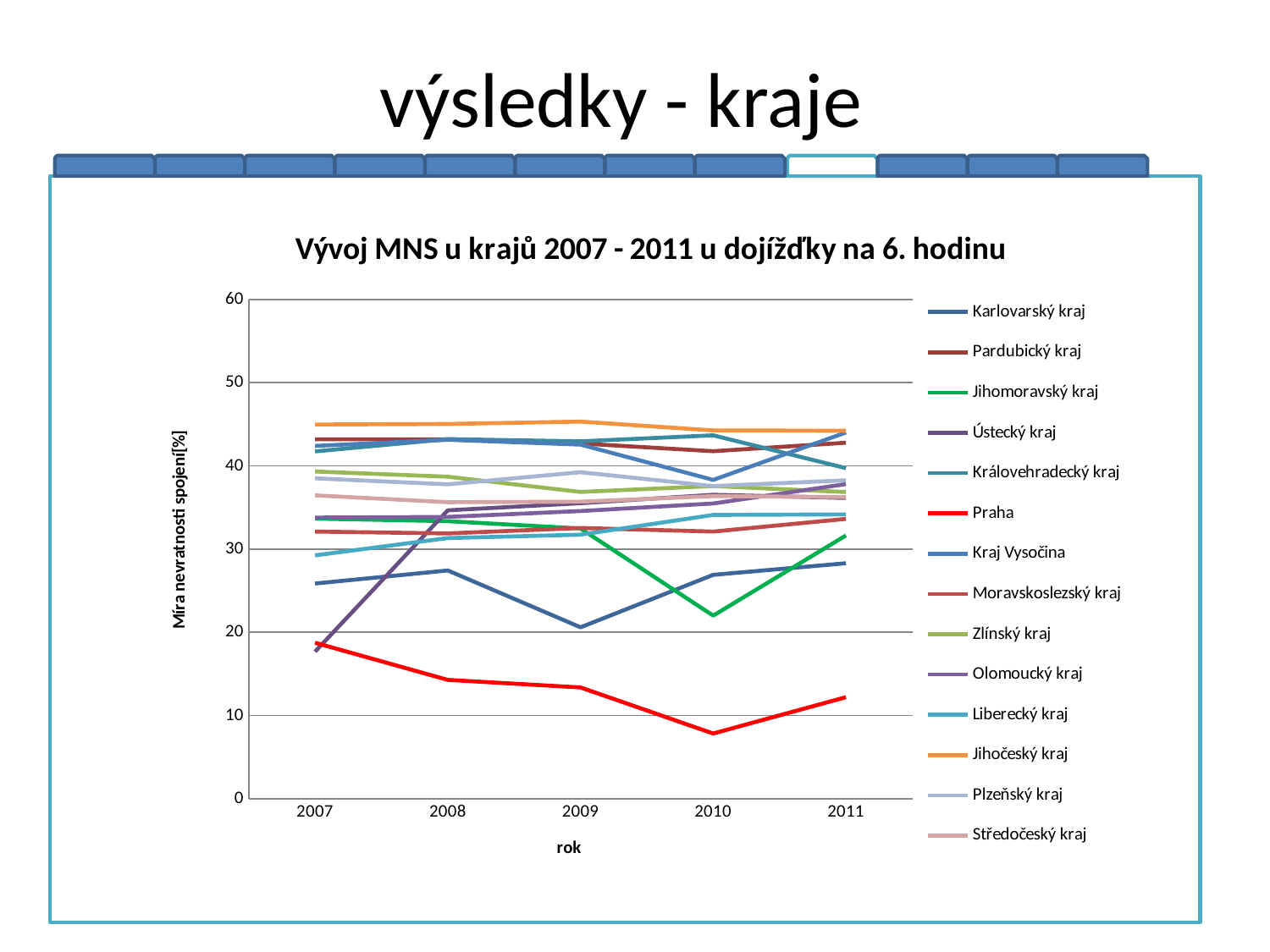
Which is larger in 2010, the value for Karlovarský kraj or for Jihomoravský kraj? Karlovarský kraj Which region has the lowest value in 2010? Praha What is the label of the x axis? rok Is the value for Jihočeský kraj in 2009 greater or less than 40? greater Which region has the highest value in 2009? Jihočeský kraj How many years are shown on the x axis? 5 What kind of chart is shown on the slide? line chart Is the value for Karlovarský kraj in 2009 greater or less than 30? less Is the value for Praha in 2010 greater or less than 10? less What is the title of the chart? Vývoj MNS u krajů 2007 - 2011 u dojížďky na 6. hodinu Does the value for Praha rise or fall from 2007 to 2010? fall How many series does the legend list? 14